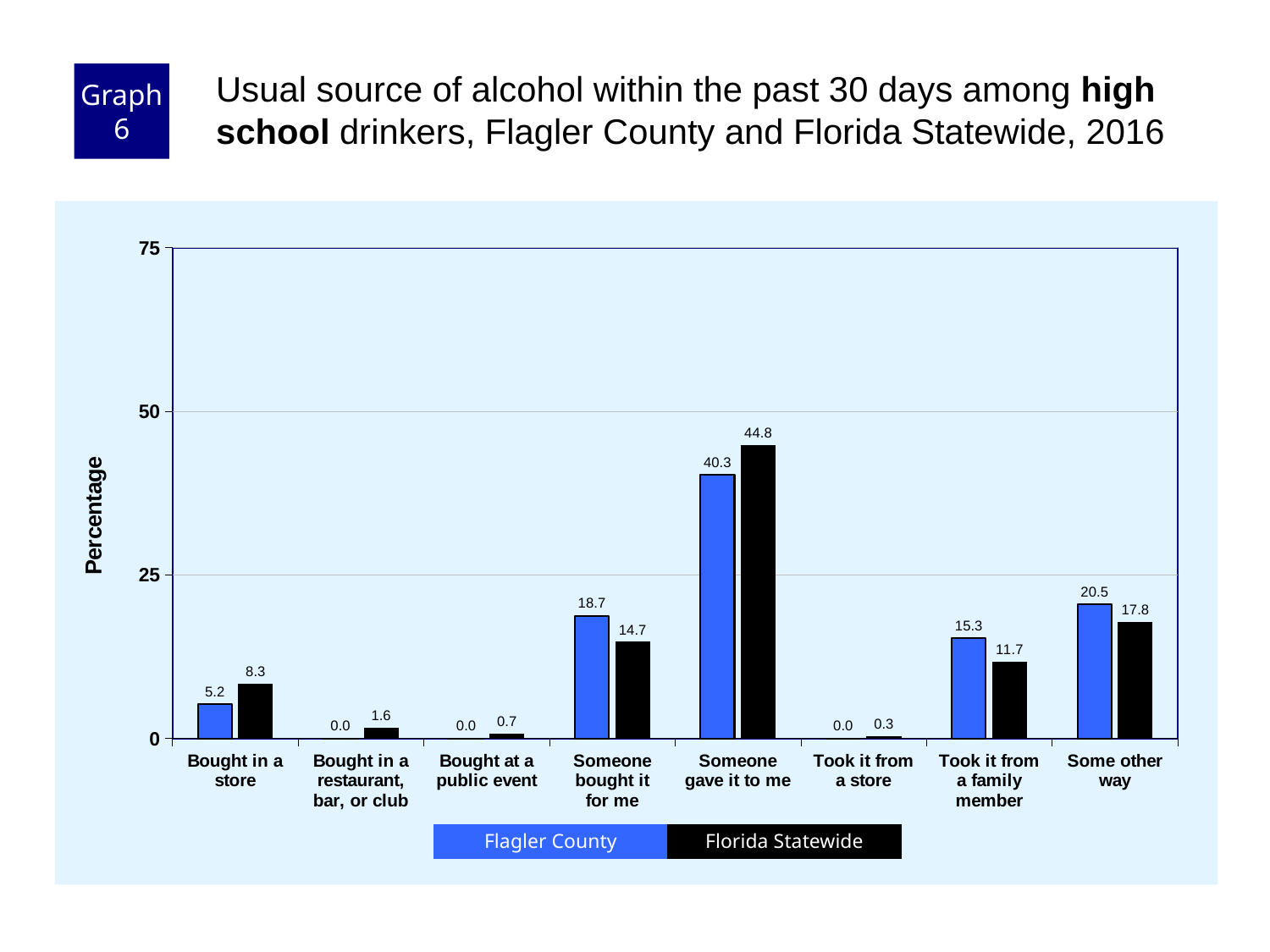
How many categories are shown on the x axis? 8 For "Some other way", which is larger: Flagler County or Florida Statewide? Flagler County What is the difference between the Florida Statewide and Flagler County values for "Someone gave it to me"? 4.5 What is the difference between the Flagler County and Florida Statewide values for "Someone bought it for me"? 4.0 Which category has the highest Florida Statewide value? Someone gave it to me What is the Flagler County value for "Someone gave it to me"? 40.3 What kind of chart is shown on the slide? bar chart What is the Flagler County value for "Bought in a store"? 5.2 How many series does the legend list? 2 Is the Florida Statewide value for "Someone gave it to me" greater or less than 50? less Which category has the lowest Florida Statewide value? Took it from a store What is the Florida Statewide value for "Took it from a family member"? 11.7